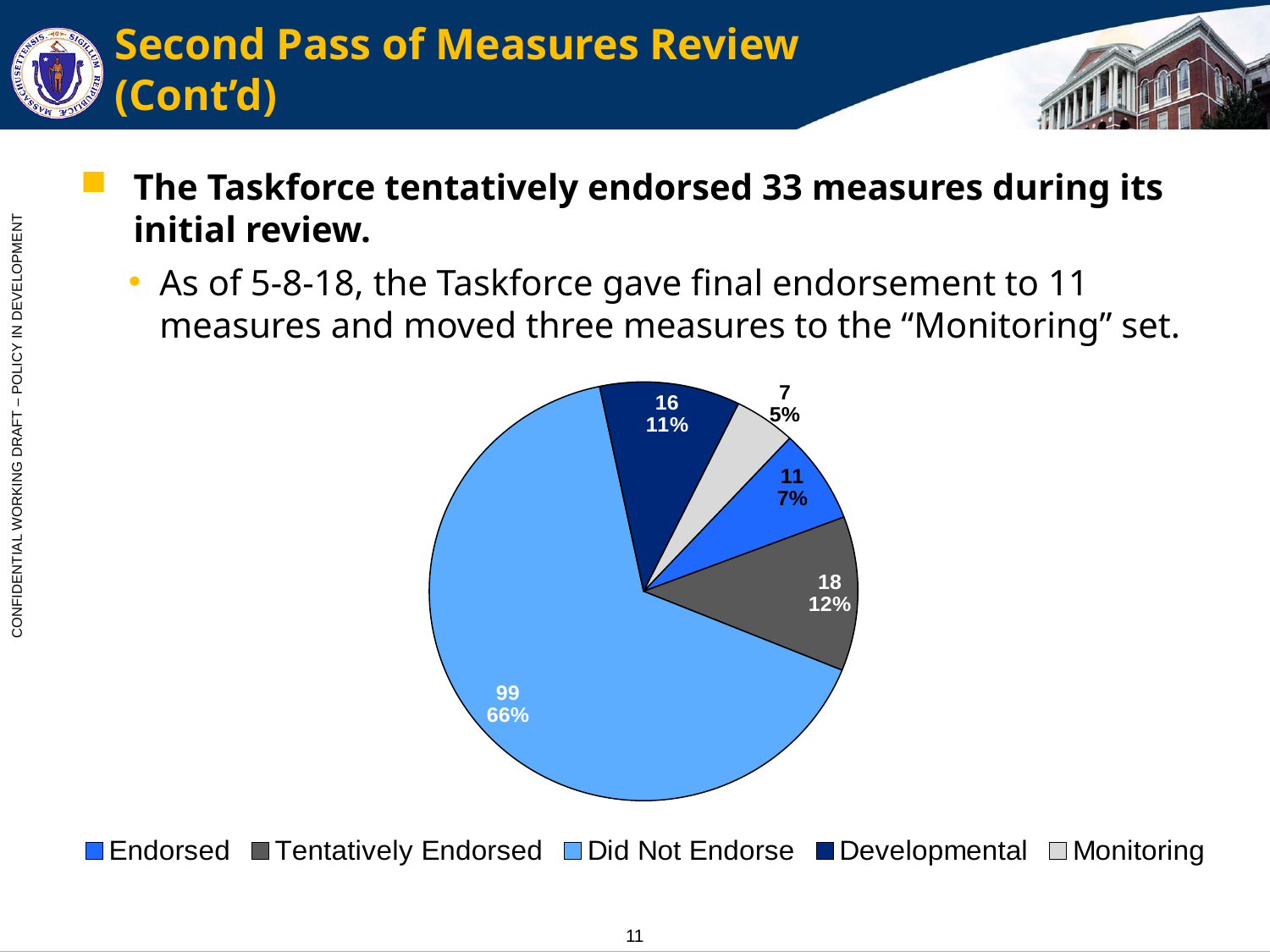
Which category has the smallest slice of the pie? Monitoring What type of chart is shown on the slide? pie chart How many categories does the legend list? 5 What is the difference between the number of Tentatively Endorsed measures and the number of Endorsed measures? 7 How many measures are in the Did Not Endorse slice? 99 What percentage share does the Tentatively Endorsed slice have? 12% What percentage share does the Developmental slice have? 11% How many measures are in the Endorsed slice? 11 How many measures are in the Monitoring slice? 7 What is the total number of measures across all slices of the pie? 151 Which is larger, the Developmental slice or the Monitoring slice? Developmental Which category has the largest slice of the pie? Did Not Endorse